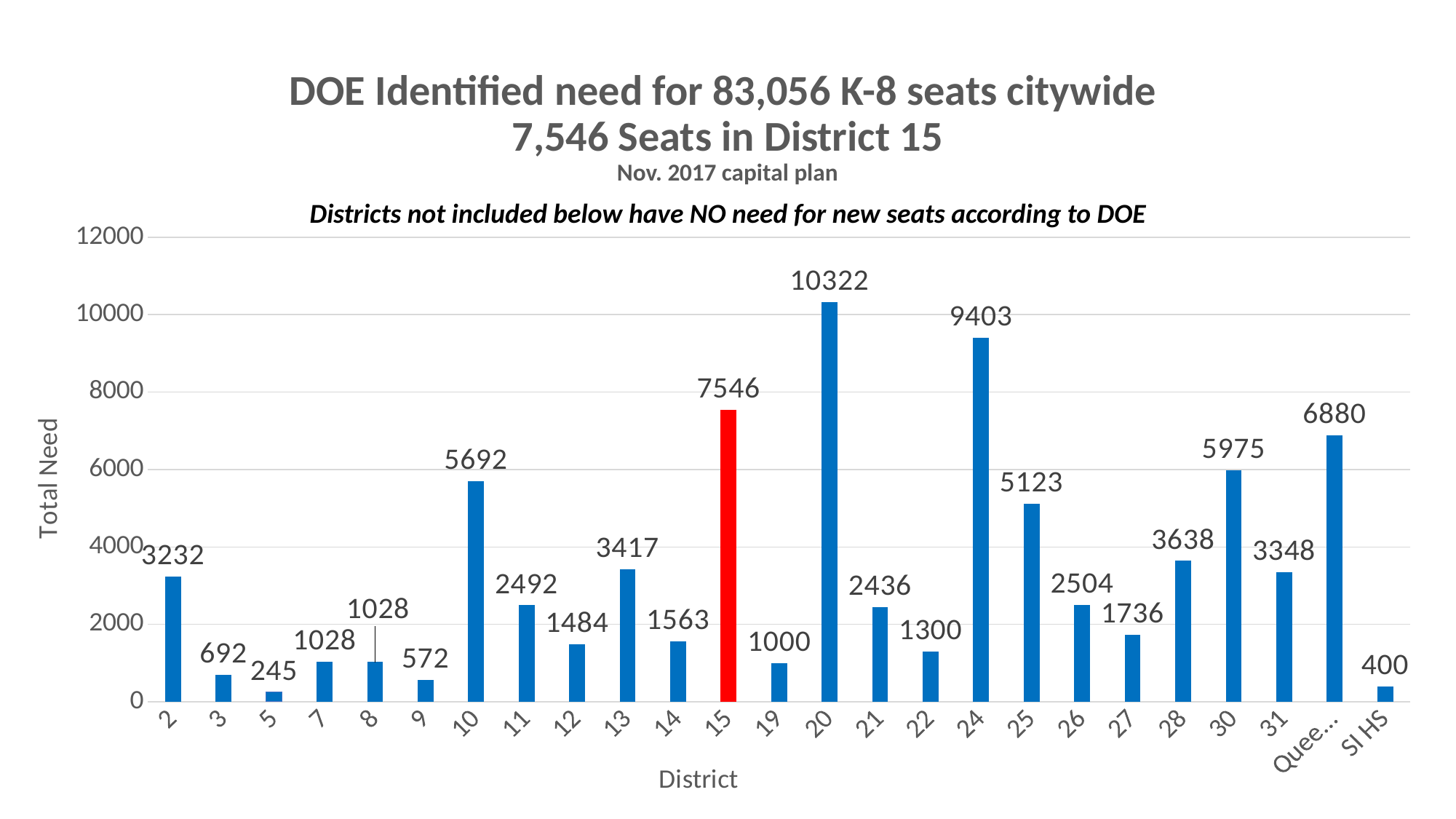
What is the total need value for District 31? 3348 What is the total need value for District 15? 7546 What is the total need value for District 20? 10322 Which bar is coloured red instead of blue? District 15 How many districts are shown on the x axis? 25 What is the difference in total need between District 15 and District 10? 1854 Which district has the highest total need? 20 What kind of chart is shown on the slide? Bar chart Which district has the lowest total need? 5 Is the value for District 24 greater or less than 8000? greater What is the difference in total need between District 20 and District 24? 919 Which has a larger total need, District 25 or District 30? District 30